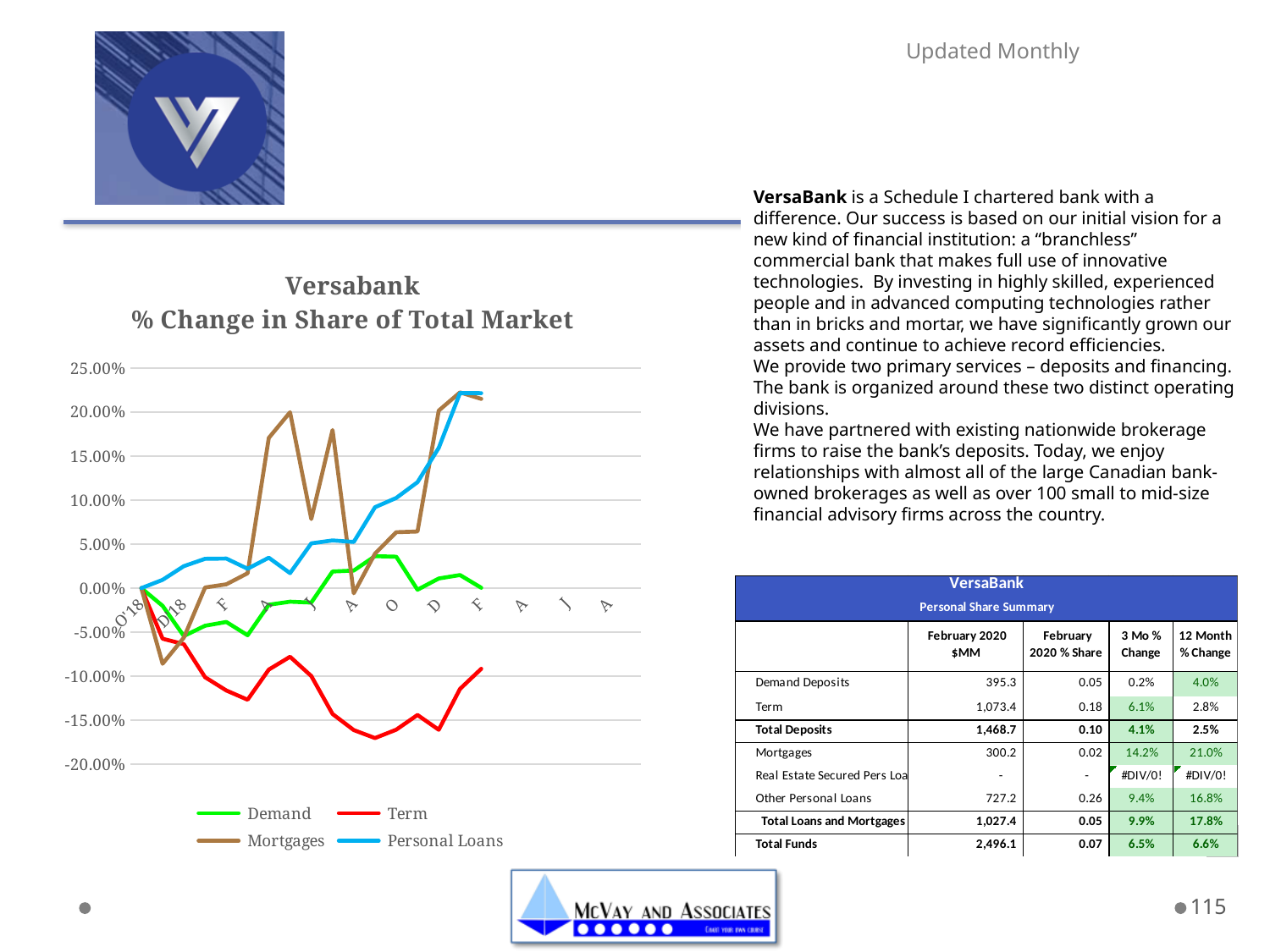
At the right end of the plotted lines, which is higher: Personal Loans or Term? Personal Loans Is the highest value of the Personal Loans series greater or less than 20.00%? greater How many series does the legend of the chart list? 4 Does the Personal Loans series overall rise or fall from the start to the end of the plotted data? rise Is the lowest value of the Term series greater or less than -15.00%? less What is the highest value shown on the vertical axis of the chart? 25.00% What is the title of the chart? Versabank % Change in Share of Total Market Does the Term series overall rise or fall from the start to the end of the plotted data? fall What kind of chart is shown on the slide? Line chart Is the final value of the Term series greater or less than -5.00%? less What are the four series named in the chart legend? Demand, Term, Mortgages, Personal Loans Which series reaches the lowest value on the chart? Term